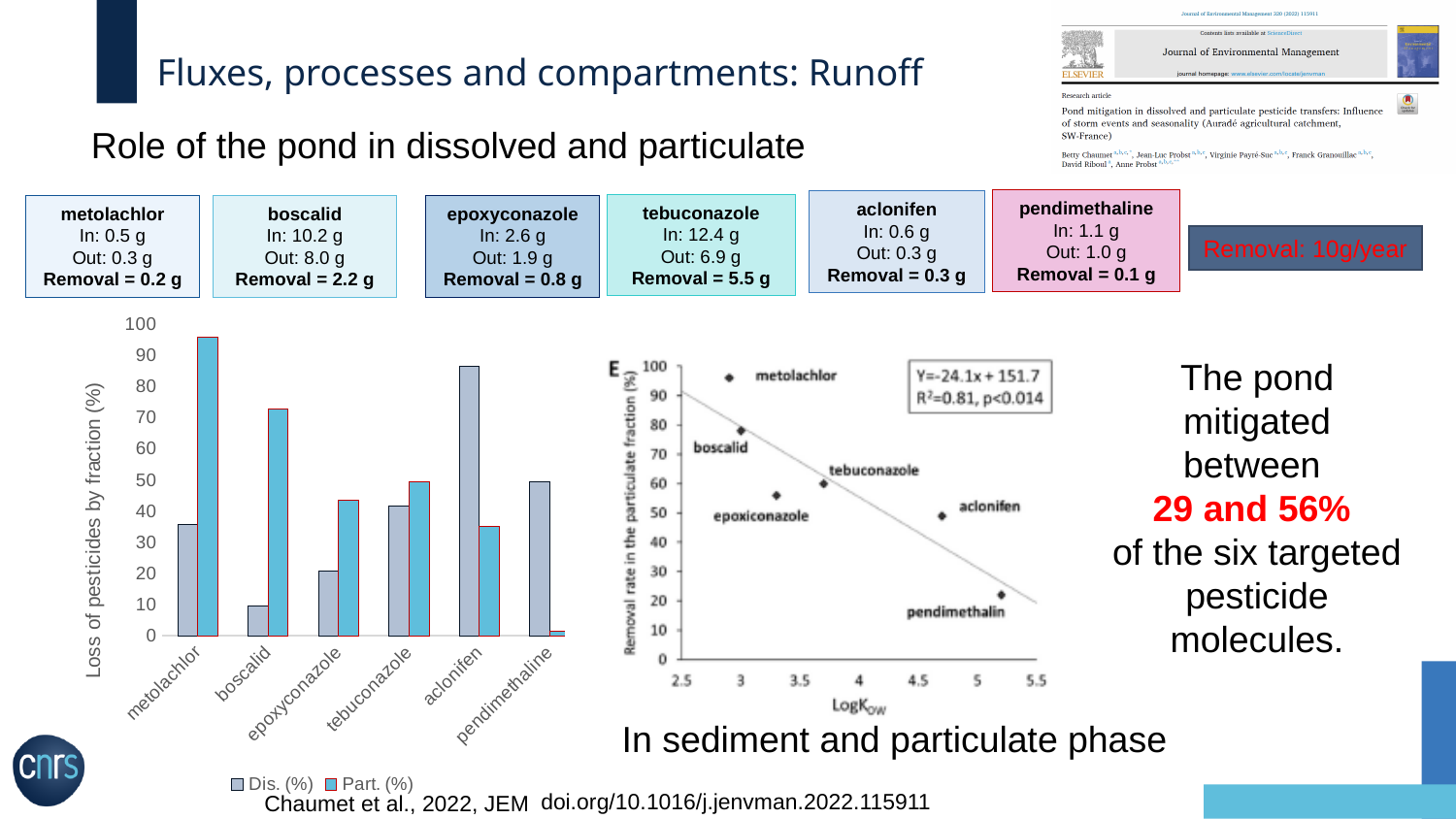
In the left bar chart, which pesticide has the highest Dis. (%) value? aclonifen In the left bar chart, how many pesticide categories are shown on the x axis? 6 In the scatter chart labelled E, which pesticide has the lowest removal rate in the particulate fraction? pendimethalin In the left bar chart, is the Part. (%) value for boscalid greater or less than 60? greater In the left bar chart, which pesticide has the highest Part. (%) value? metolachlor In the left bar chart, is the Dis. (%) value for boscalid greater or less than 20? less What kind of chart is the chart labelled E on the right, plotting removal rate against LogKow? scatter chart What kind of chart is the chart on the left with the y axis 'Loss of pesticides by fraction (%)'? bar chart In the left bar chart, for metolachlor, which is larger: Dis. (%) or Part. (%)? Part. (%) In the left bar chart, how many series does the legend list? 2 In the left bar chart, what are the two legend entries? Dis. (%) and Part. (%) In the left bar chart, which pesticide has the lowest Part. (%) value? pendimethaline